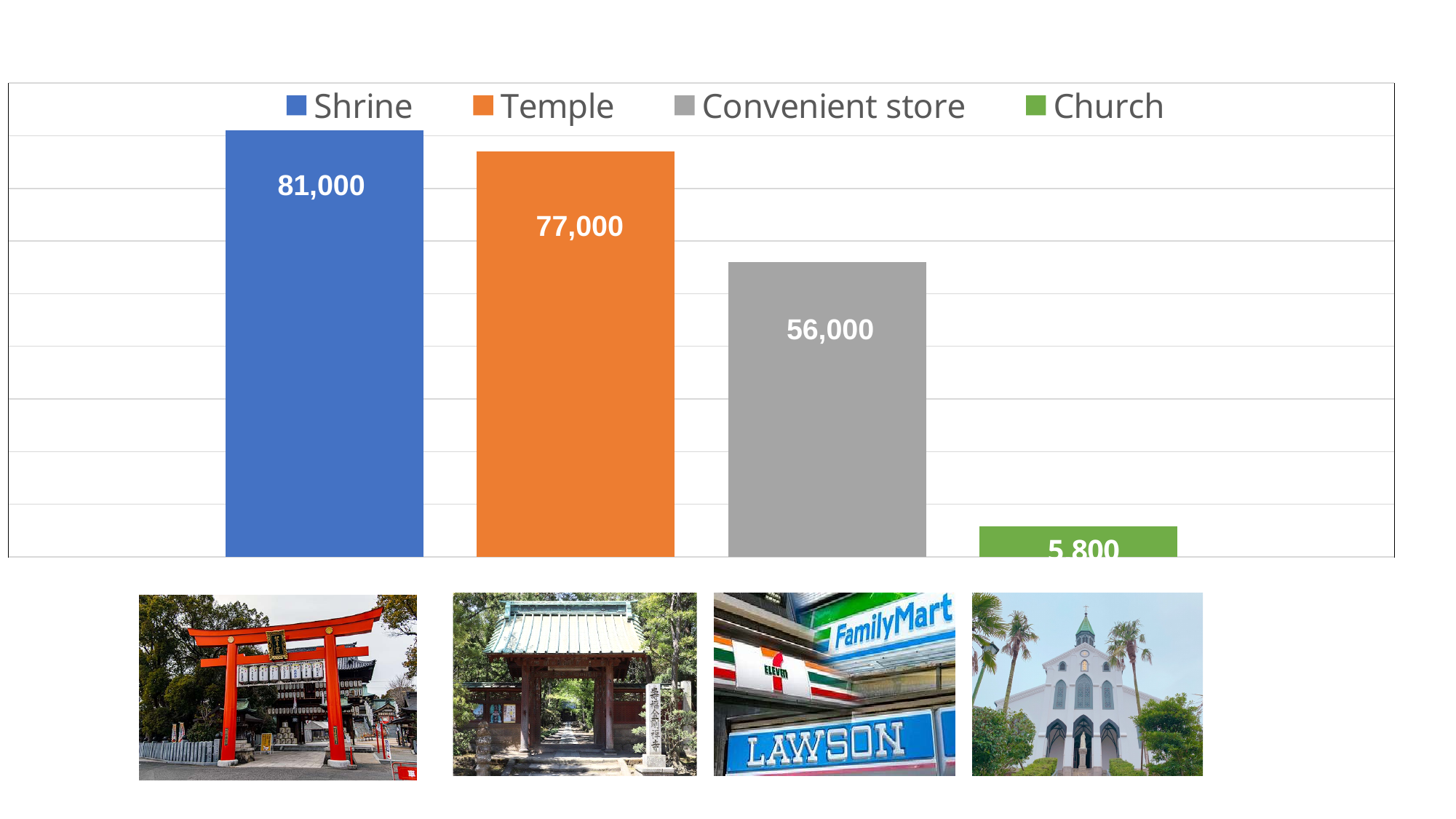
What is the difference between the values for Shrine and Temple? 4,000 Which category has the highest value? Shrine What is the value shown for Shrine? 81,000 What is the value shown for Temple? 77,000 What is the difference between the values for Temple and Convenient store? 21,000 What is the value shown for Church? 5,800 What is the value shown for Convenient store? 56,000 Which category has the lowest value? Church What kind of chart is shown on the slide? Bar chart Which is larger, the value for Convenient store or the value for Church? Convenient store How many bars are plotted in the chart? 4 How many entries does the legend list? 4